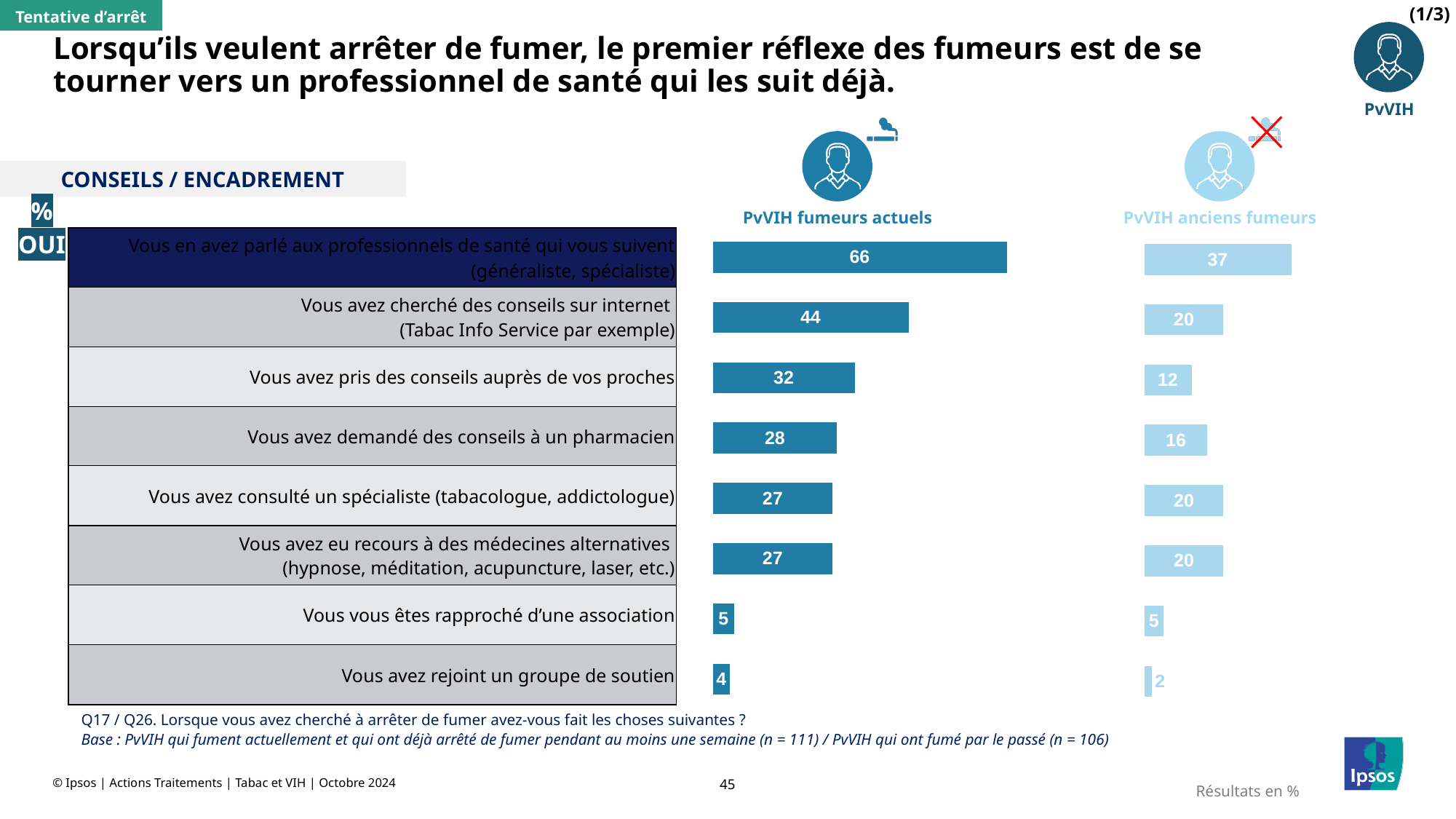
What type of chart is used for 'PvVIH anciens fumeurs'? Bar chart In the 'PvVIH fumeurs actuels' chart, which category has the highest value? Vous en avez parlé aux professionnels de santé qui vous suivent (généraliste, spécialiste) What is the difference between the 'PvVIH fumeurs actuels' and 'PvVIH anciens fumeurs' values for 'Vous avez pris des conseils auprès de vos proches'? 20 Which is larger: the 'PvVIH fumeurs actuels' value for 'Vous avez demandé des conseils à un pharmacien' or the 'PvVIH anciens fumeurs' value for the same category? PvVIH fumeurs actuels What is the value for 'Vous vous êtes rapproché d'une association' in the 'PvVIH fumeurs actuels' chart? 5 In the 'PvVIH anciens fumeurs' chart, what is the value for 'Vous avez rejoint un groupe de soutien'? 2 In the 'PvVIH fumeurs actuels' chart, what is the difference between 'Vous avez cherché des conseils sur internet' and 'Vous avez consulté un spécialiste (tabacologue, addictologue)'? 17 How many categories are shown in the 'PvVIH fumeurs actuels' chart? 8 In the 'PvVIH anciens fumeurs' chart, which category has the lowest value? Vous avez rejoint un groupe de soutien In the 'PvVIH fumeurs actuels' chart, what is the value for 'Vous en avez parlé aux professionnels de santé qui vous suivent (généraliste, spécialiste)'? 66 In the 'PvVIH anciens fumeurs' chart, what is the value for 'Vous avez cherché des conseils sur internet (Tabac Info Service par exemple)'? 20 In the 'PvVIH fumeurs actuels' chart, what is the value for 'Vous avez demandé des conseils à un pharmacien'? 28